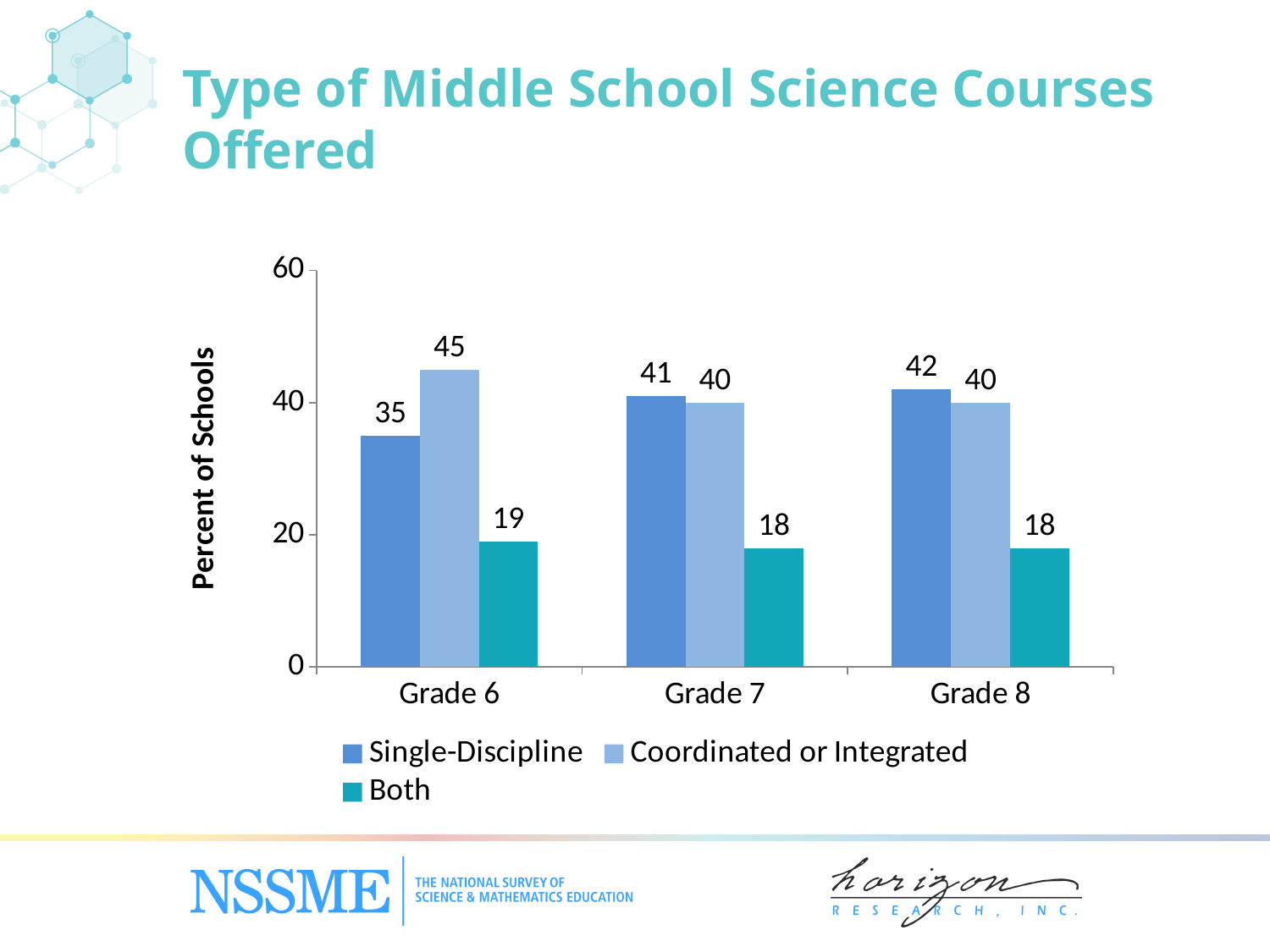
How many series does the legend list? 3 Which grade has the lowest value for Single-Discipline? Grade 6 What is the label of the y axis? Percent of Schools What kind of chart is shown on the slide? Bar chart How many grade categories are shown on the x axis? 3 What is the difference between the Coordinated or Integrated and Single-Discipline values in Grade 6? 10 What is the value for Single-Discipline in Grade 6? 35 Which is larger in Grade 8: Single-Discipline or Both? Single-Discipline Is the value for Both in Grade 7 greater or less than 20? less What is the value for Both in Grade 8? 18 Which grade has the highest value for Coordinated or Integrated? Grade 6 What is the value for Coordinated or Integrated in Grade 7? 40